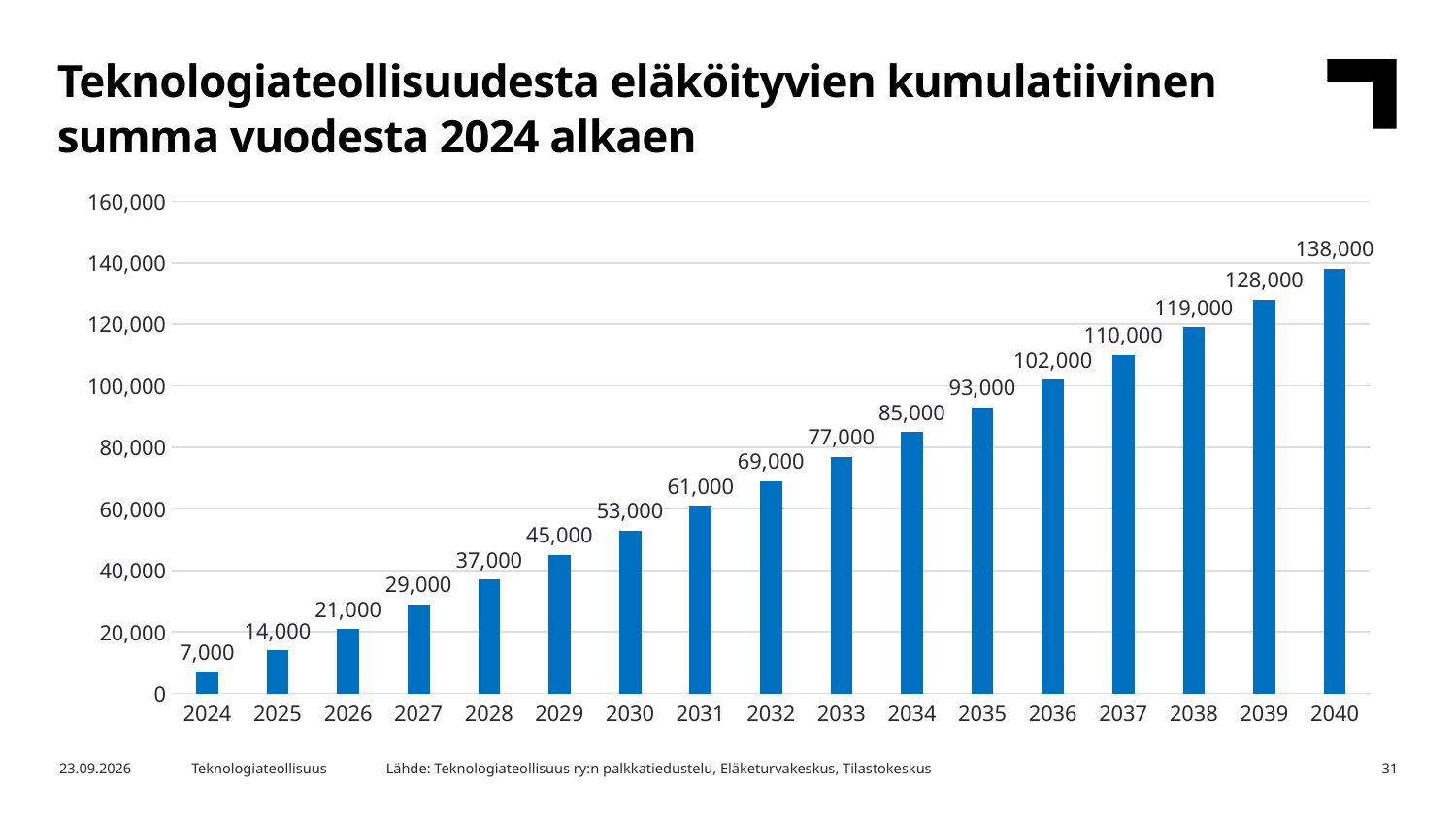
Is the value for 2037 greater or less than 100,000? greater What kind of chart is shown on the slide? bar chart Do the values rise or fall from 2024 to 2040? rise What is the value shown for 2024? 7,000 Which year has the highest value? 2040 How many years are shown on the x axis? 17 Which is larger, the value for 2032 or the value for 2035? 2035 What is the cumulative value shown for 2030? 53,000 What is the value shown for 2036? 102,000 What is the difference between the values for 2034 and 2028? 48,000 What is the difference between the values for 2040 and 2039? 10,000 Which year has the lowest value? 2024